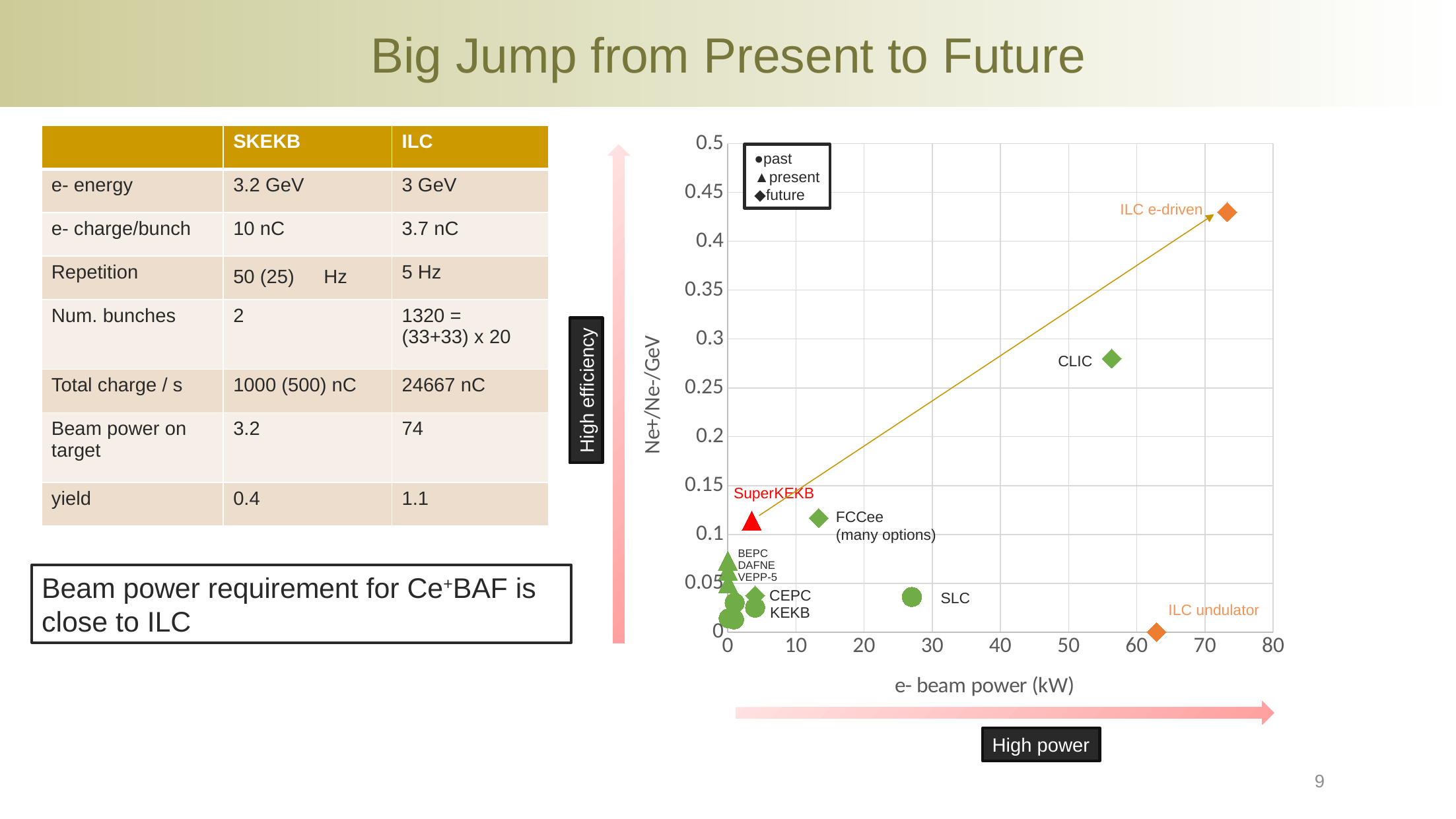
Is the Ne+/Ne-/GeV value for ILC e-driven greater or less than 0.4? greater Which has the higher e- beam power, ILC e-driven or ILC undulator? ILC e-driven Which has the higher Ne+/Ne-/GeV value, CLIC or FCCee? CLIC Which labelled point has the highest Ne+/Ne-/GeV value? ILC e-driven What is the title of the x axis of the chart? e- beam power (kW) Which labelled point has the lowest Ne+/Ne-/GeV value? ILC undulator Is the e- beam power for CLIC greater or less than 50 kW? greater What are the three entries in the chart legend? past, present, future Which labelled point has the highest e- beam power? ILC e-driven What kind of chart is shown on the right of the slide? scatter chart Is the e- beam power for SLC greater or less than 30 kW? less How many series does the chart legend list? 3